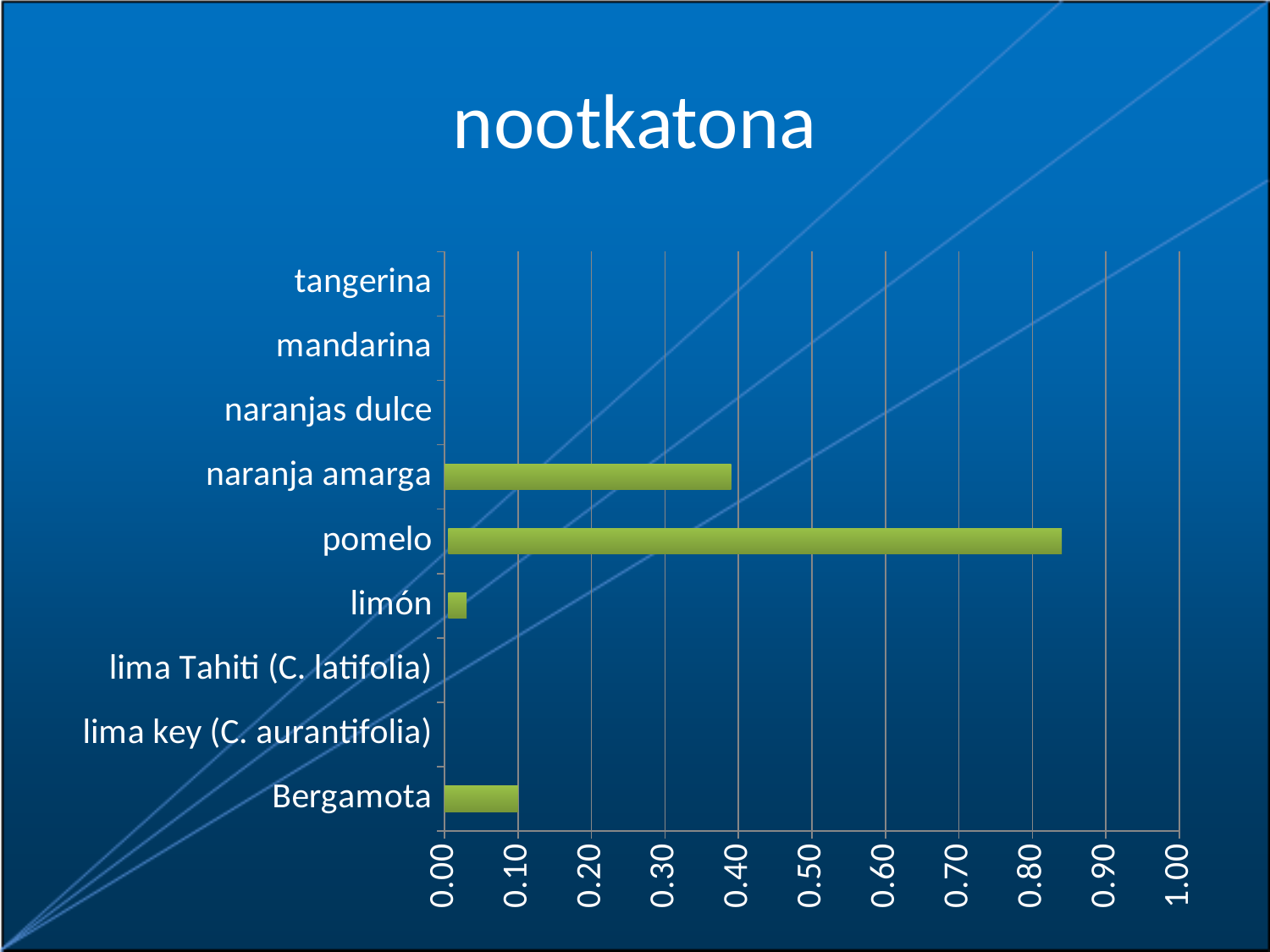
Is the value for naranja amarga greater or less than 0.30? greater What is the title of the chart? nootkatona What kind of chart is shown on the slide? bar chart Is the value for naranja amarga greater or less than 0.50? less How many categories in the chart have a visible bar? 4 Which has a larger value, pomelo or naranja amarga? pomelo Which category has the highest value in the chart? pomelo Is the value for pomelo greater or less than 0.80? greater How many categories are listed on the vertical axis of the chart? 9 Which has a larger value, Bergamota or limón? Bergamota